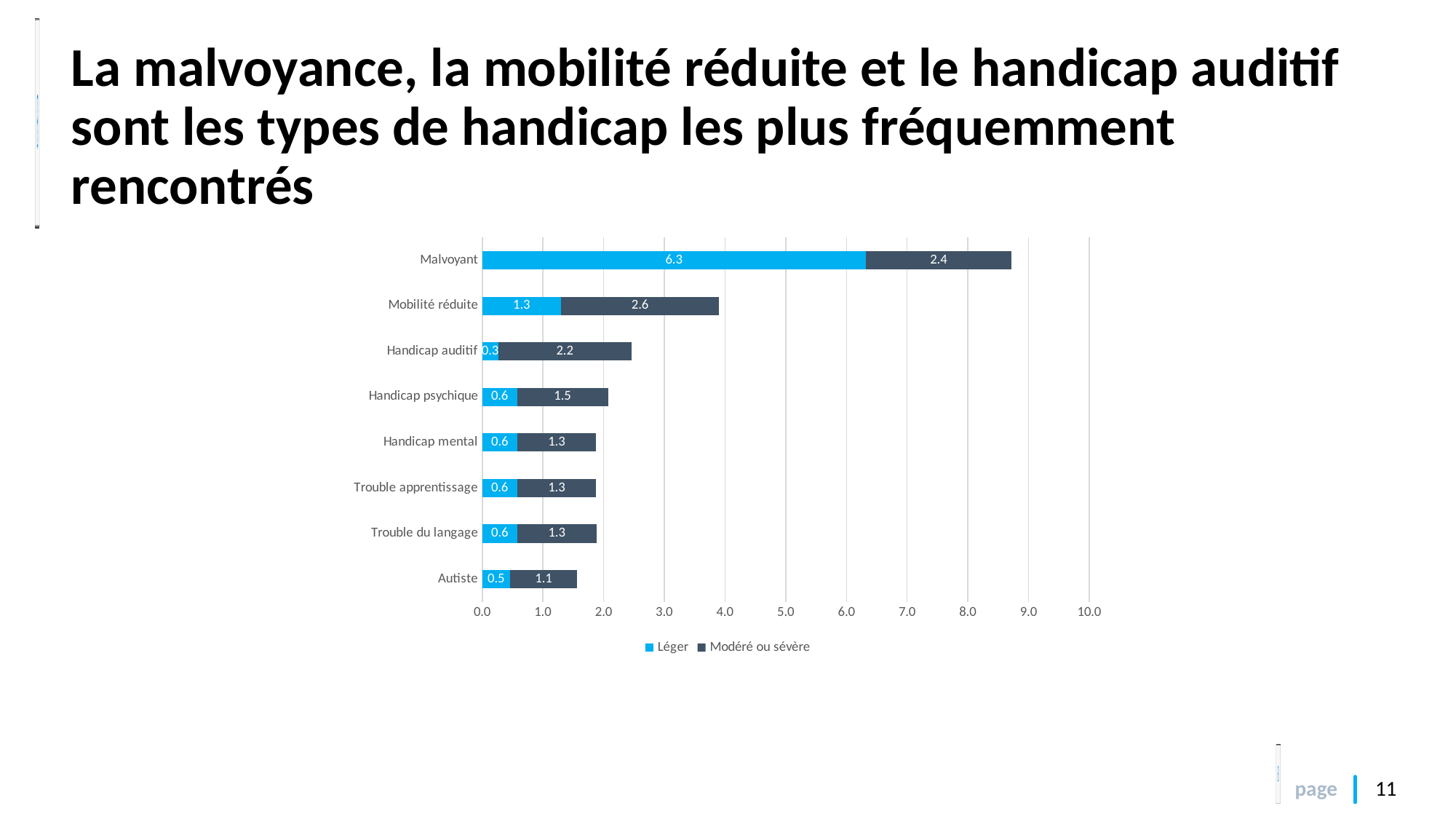
What is the total of the stacked bar for Mobilité réduite? 3.9 How many series does the legend list? 2 Which is larger: the 'Modéré ou sévère' value for Handicap psychique or for Handicap mental? Handicap psychique What is the 'Léger' value for Malvoyant? 6.3 What is the 'Modéré ou sévère' value for Mobilité réduite? 2.6 What is the total of the stacked bar for Malvoyant? 8.7 Which category has the lowest 'Modéré ou sévère' value? Autiste How many categories are shown on the chart? 8 What is the 'Léger' value for Handicap auditif? 0.3 Which category has the highest 'Léger' value? Malvoyant What is the difference between the 'Modéré ou sévère' values for Mobilité réduite and Handicap auditif? 0.4 What is the 'Modéré ou sévère' value for Autiste? 1.1